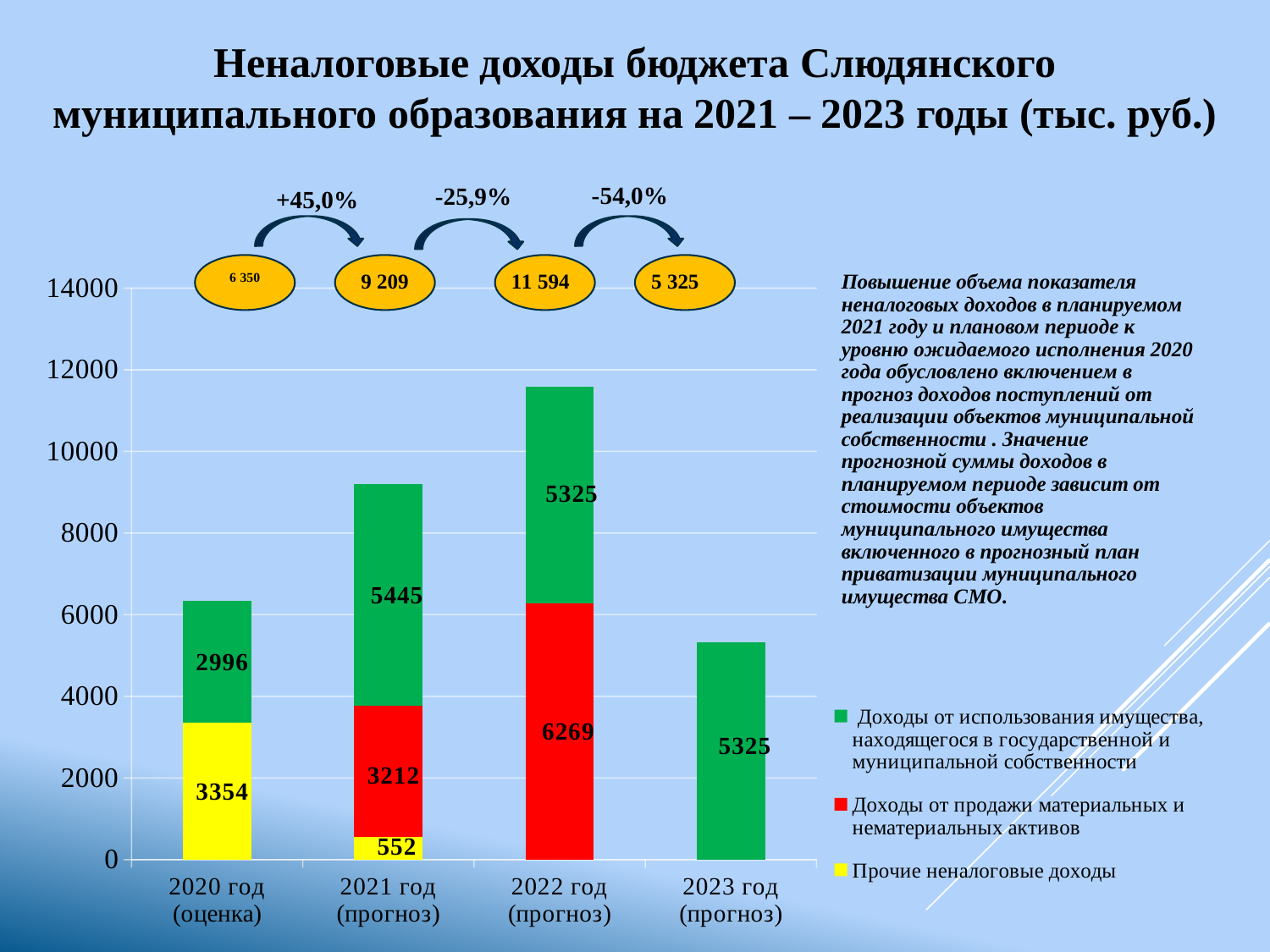
What is the value of 'Доходы от продажи материальных и нематериальных активов' for 2022 год (прогноз)? 6269 Which year has the highest total non-tax revenue? 2022 год (прогноз) What is the total of the stacked bar for 2021 год (прогноз)? 9 209 What is the value of 'Доходы от использования имущества, находящегося в государственной и муниципальной собственности' for 2021 год (прогноз)? 5445 How many series does the legend list? 3 How many year categories are shown on the x axis of the chart? 4 What is the value of 'Прочие неналоговые доходы' for 2020 год (оценка)? 3354 What type of chart is shown on the slide? stacked bar chart Which is larger: 'Прочие неналоговые доходы' in 2020 год or in 2021 год? 2020 год What percentage change is shown between 2021 год and 2022 год above the chart? -25,9% What is the difference between the 'Доходы от продажи материальных и нематериальных активов' values for 2022 год and 2021 год? 3057 Which year has the lowest total non-tax revenue? 2023 год (прогноз)